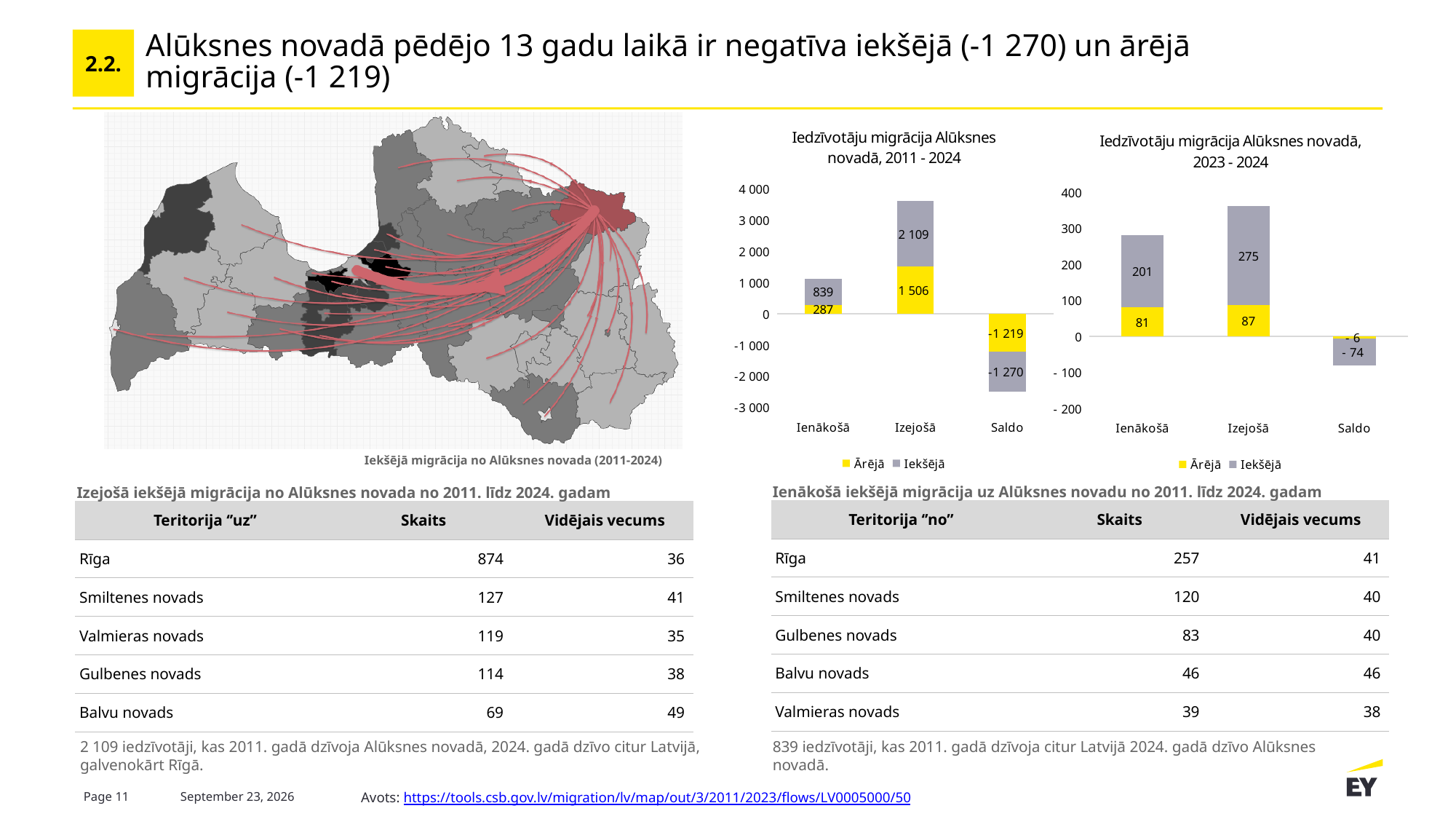
What kind of chart is 'Iedzīvotāju migrācija Alūksnes novadā, 2011 - 2024'? Stacked bar chart In the chart 'Iedzīvotāju migrācija Alūksnes novadā, 2023 - 2024', which category has the highest Iekšējā value? Izejošā How many series does the legend of the chart 'Iedzīvotāju migrācija Alūksnes novadā, 2023 - 2024' list? 2 In the chart 'Iedzīvotāju migrācija Alūksnes novadā, 2011 - 2024', what is the difference between the Iekšējā values for Izejošā and Ienākošā? 1 270 In the chart 'Iedzīvotāju migrācija Alūksnes novadā, 2023 - 2024', what is the Iekšējā value for Saldo? - 74 In the chart 'Iedzīvotāju migrācija Alūksnes novadā, 2011 - 2024', what is the Iekšējā value for Izejošā? 2 109 In the chart 'Iedzīvotāju migrācija Alūksnes novadā, 2011 - 2024', what is the Ārējā value for Saldo? -1 219 In the chart 'Iedzīvotāju migrācija Alūksnes novadā, 2023 - 2024', what is the Iekšējā value for Izejošā? 275 In the chart 'Iedzīvotāju migrācija Alūksnes novadā, 2011 - 2024', what is the total of the stacked bar for Izejošā? 3 615 In the chart 'Iedzīvotāju migrācija Alūksnes novadā, 2011 - 2024', which is larger for Ienākošā: the Ārējā value or the Iekšējā value? Iekšējā In the chart 'Iedzīvotāju migrācija Alūksnes novadā, 2011 - 2024', what is the Ārējā value for Ienākošā? 287 In the chart 'Iedzīvotāju migrācija Alūksnes novadā, 2023 - 2024', what is the total of the stacked bar for Ienākošā? 282